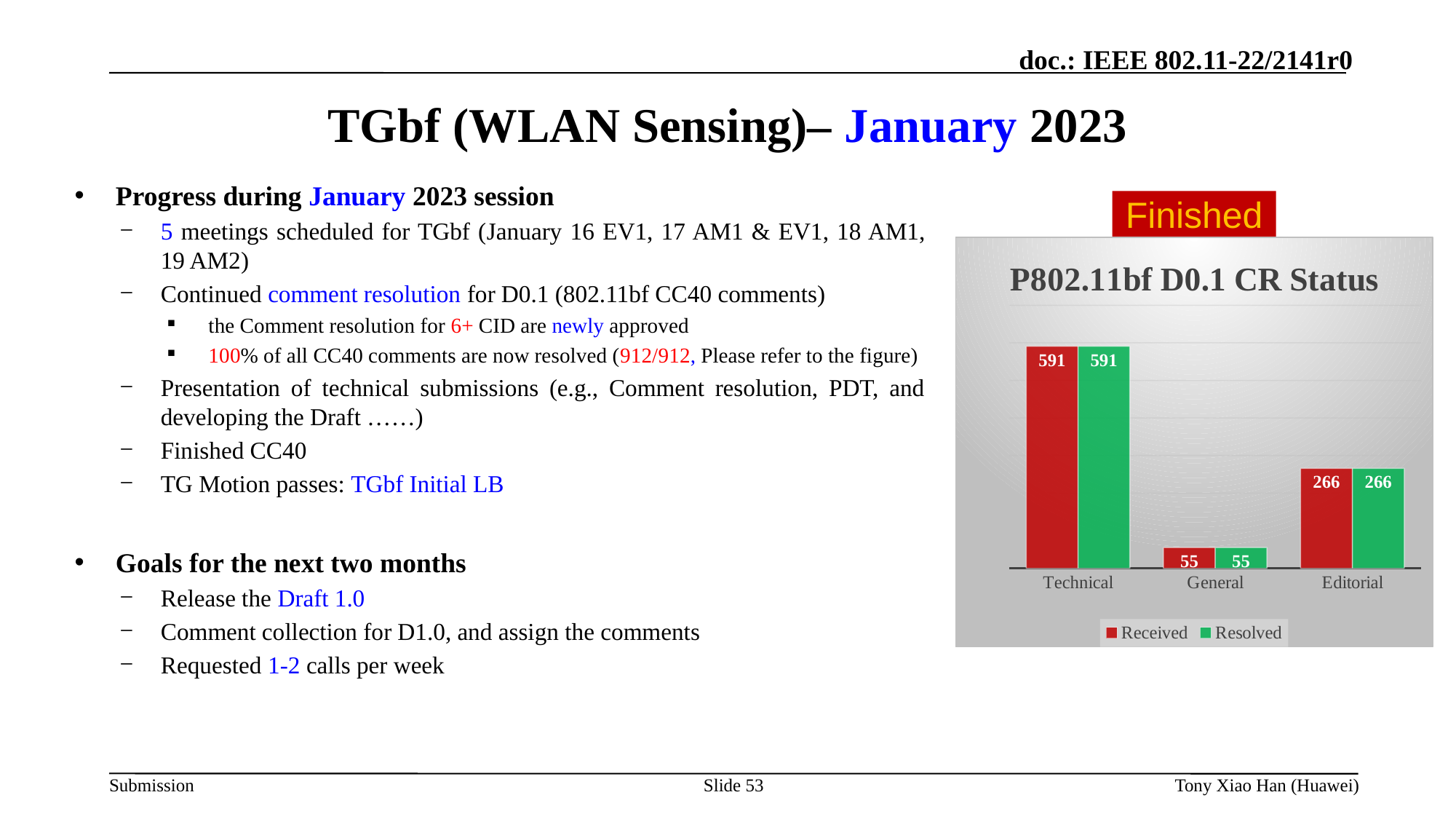
What is the Resolved value for General? 55 Which category has the lowest Resolved value? General How many series does the chart legend list? 2 What is the title of the chart? P802.11bf D0.1 CR Status Which category has the highest Received value? Technical Which colour represents the Resolved series in the chart? green What is the difference between the Received values for Technical and Editorial? 325 How many categories are shown on the x axis of the chart? 3 What is the Received value for Editorial? 266 Which is larger, the Resolved value for Editorial or the Resolved value for General? Editorial What type of chart is shown on the slide? bar chart What is the Received value for Technical? 591